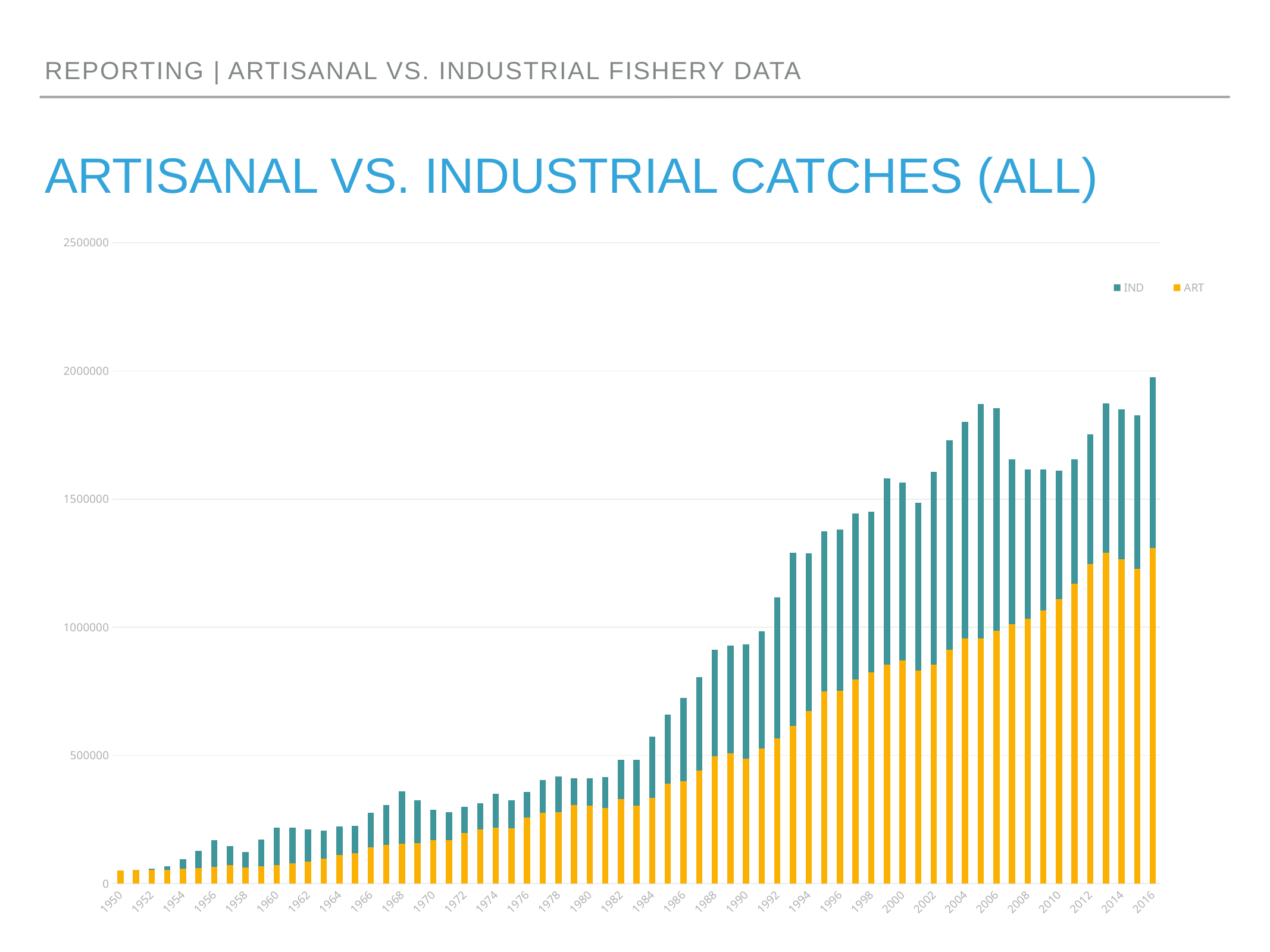
Is the ART value for 2016 greater or less than 1000000? greater How many series does the legend list? 2 Is the total catch for 2005 greater or less than 1500000? greater Overall, do total catches rise or fall from 1950 to 2016? Rise Is the total catch for 2016 greater or less than 1500000? greater In 2016, which series is larger, IND or ART? ART Which year has the highest total catch? 2016 What kind of chart is shown on the slide? Stacked bar chart Which colour represents the ART series? Yellow What are the two series named in the legend? IND and ART